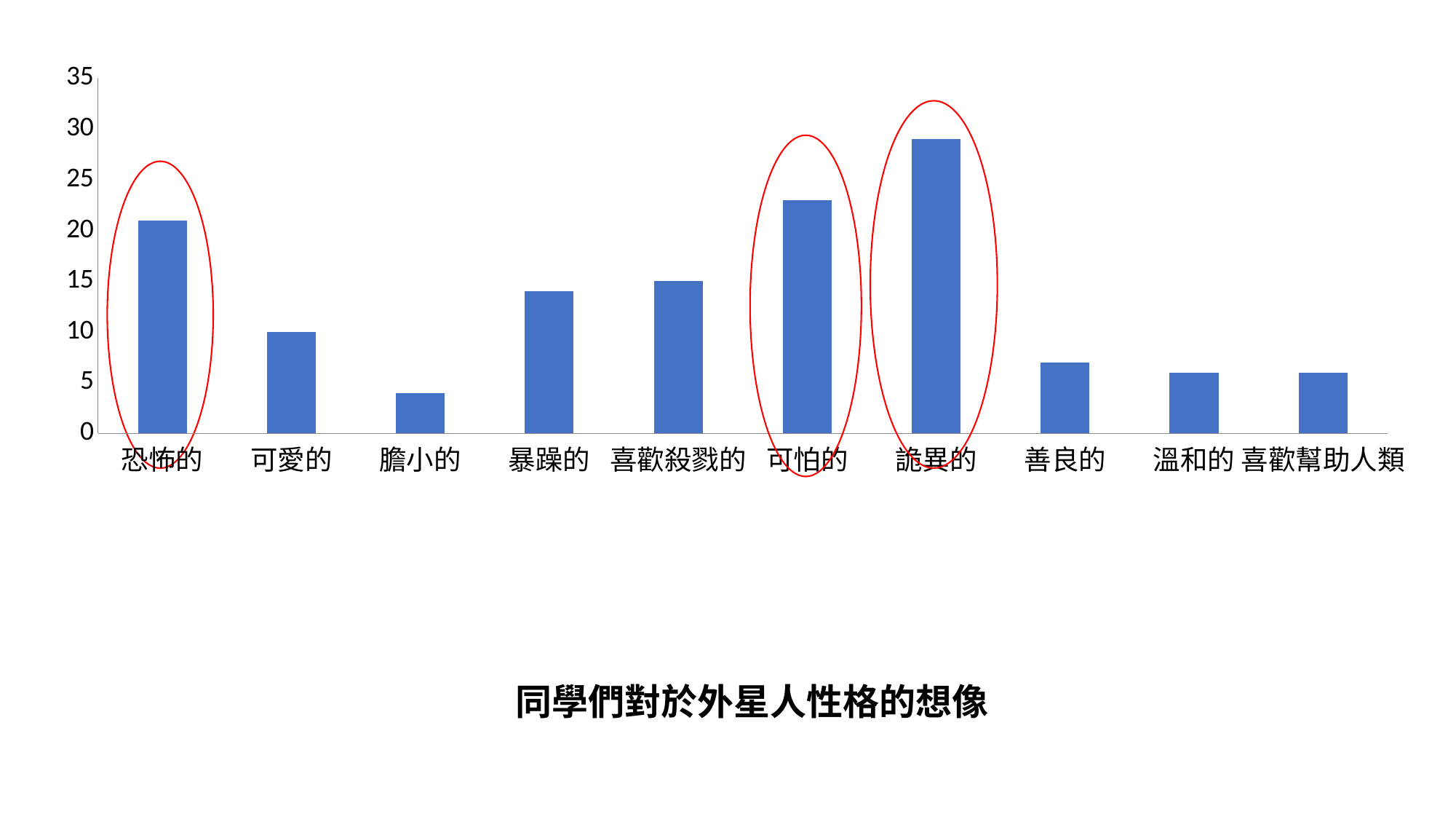
Is the value for 恐怖的 greater or less than 20? greater Which is larger, the value for 可怕的 or the value for 詭異的? 詭異的 Which category has the lowest bar? 膽小的 What kind of chart is shown on the slide? bar chart How many categories are shown on the x axis? 10 Which category has the highest bar? 詭異的 Which is larger, the value for 恐怖的 or the value for 可愛的? 恐怖的 Is the value for 詭異的 greater or less than 25? greater Which is larger, the value for 善良的 or the value for 暴躁的? 暴躁的 What is the title of the chart? 同學們對於外星人性格的想像 Is the value for 膽小的 greater or less than 5? less Which three categories are circled in red on the chart? 恐怖的, 可怕的, 詭異的